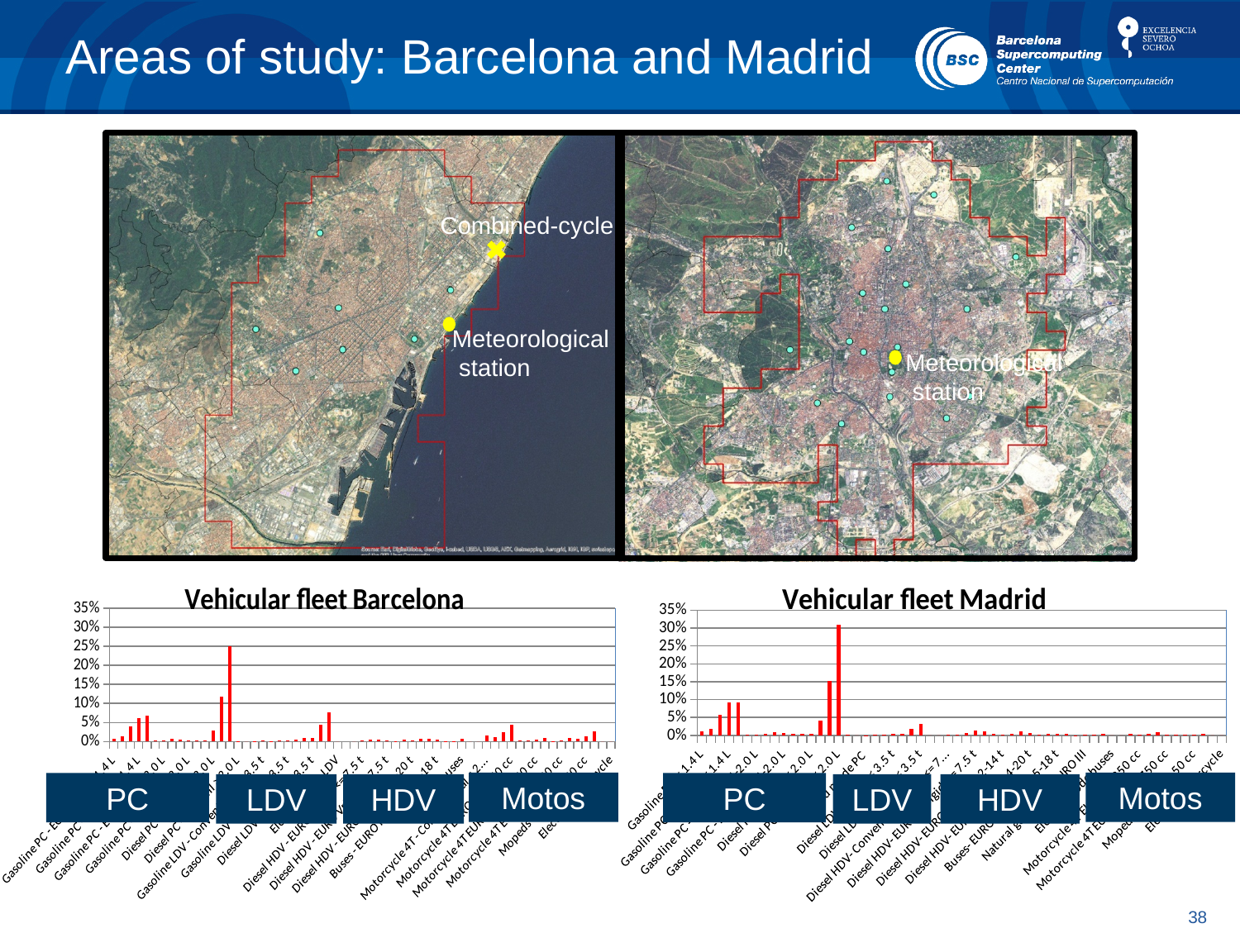
In the "Vehicular fleet Barcelona" chart, is the value of the tallest bar greater or less than 30%? less Which chart has the taller maximum bar, "Vehicular fleet Barcelona" or "Vehicular fleet Madrid"? Vehicular fleet Madrid What kind of chart is the "Vehicular fleet Barcelona" chart? bar chart In the "Vehicular fleet Madrid" chart, is the value of the tallest bar greater or less than 35%? less What is the title of the bar chart on the left side of the slide? Vehicular fleet Barcelona In the "Vehicular fleet Barcelona" chart, is the value of the tallest bar greater or less than 20%? greater What is the highest value shown on the y axis of the "Vehicular fleet Madrid" chart? 35% What kind of chart is the "Vehicular fleet Madrid" chart? bar chart What is the title of the bar chart on the right side of the slide? Vehicular fleet Madrid